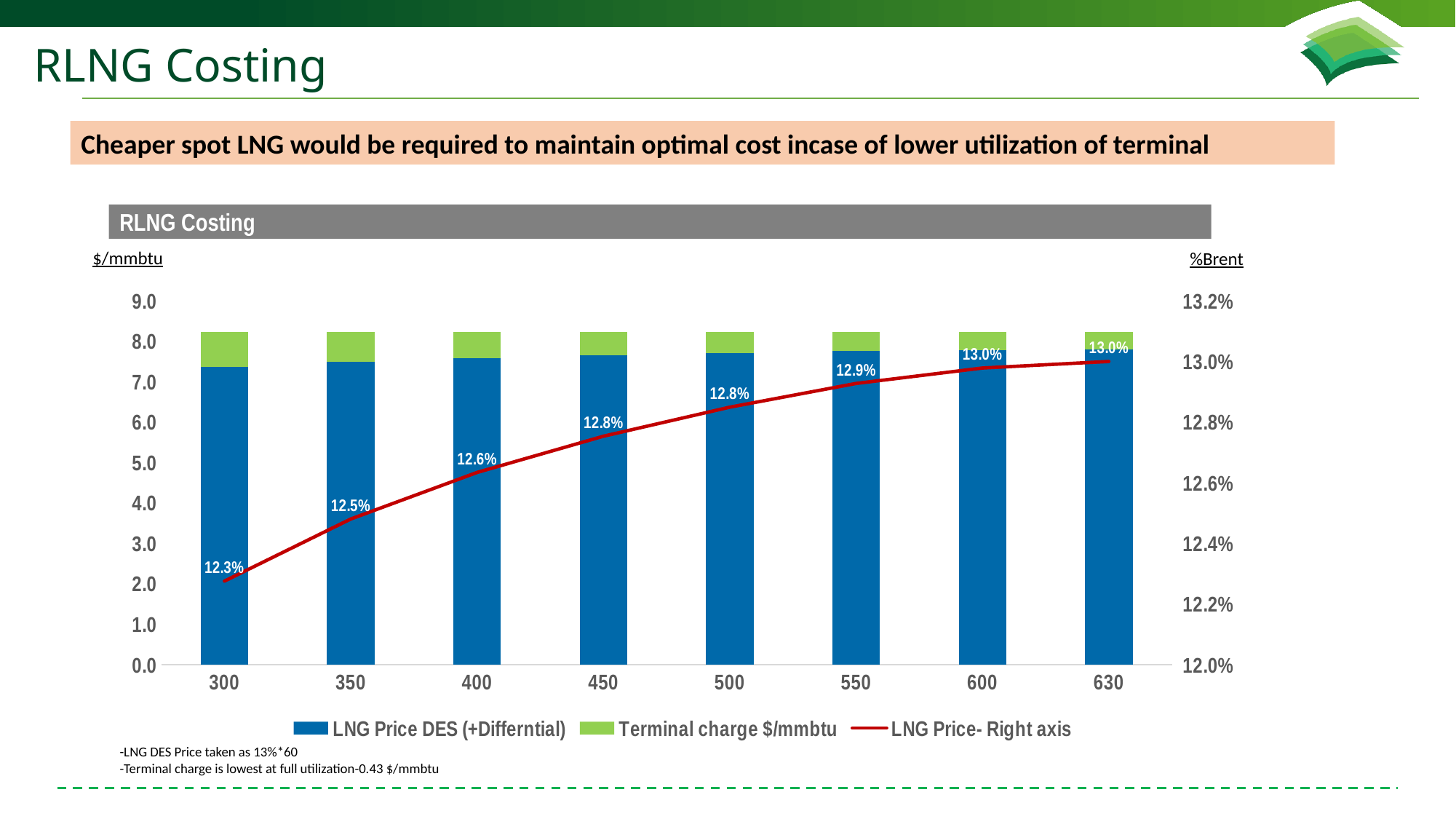
Is the LNG Price DES (+Differntial) value at 300 greater or less than 7.0? greater At which x-axis category is the LNG Price (right axis) lowest? 300 What is the LNG Price (right axis) value at 400? 12.6% Does the LNG Price (right axis) line rise or fall from 300 to 630? rise Is the total height of the stacked bar at 450 greater or less than 8.0? greater What is the difference between the LNG Price (right axis) values at 630 and 300? 0.7% What kind of chart is this? Stacked bar chart with a line Which is larger, the LNG Price (right axis) value at 350 or at 500? 500 What is the LNG Price (right axis) value at 300? 12.3% What is the LNG Price (right axis) value at 550? 12.9% How many series does the legend list? 3 How many categories are shown on the x axis? 8